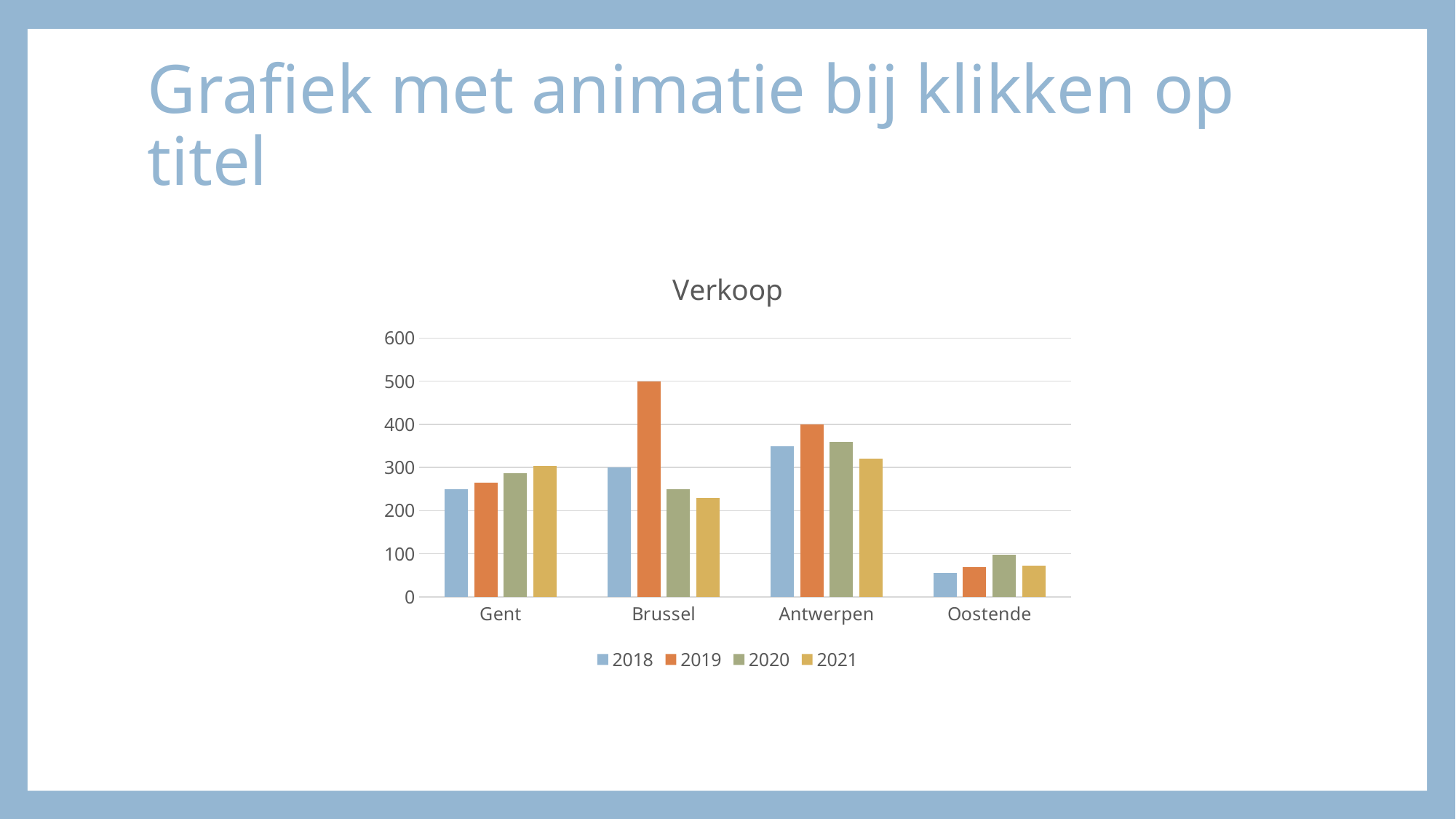
How many categories are shown on the x axis of the chart? 4 Which series is shown in orange in the legend? 2019 Which category has the lowest values across all years? Oostende Which is larger, the 2018 value for Antwerpen or the 2018 value for Gent? Antwerpen What is the title of the chart? Verkoop What is the value for Antwerpen in 2019? 400 What is the value for Brussel in 2019? 500 What kind of chart is shown on the slide? bar chart Is the value for Antwerpen in 2018 greater or less than 300? greater Is the value for Gent in 2018 greater or less than 300? less How many series does the legend of the chart list? 4 Which category has the highest bar in the chart? Brussel